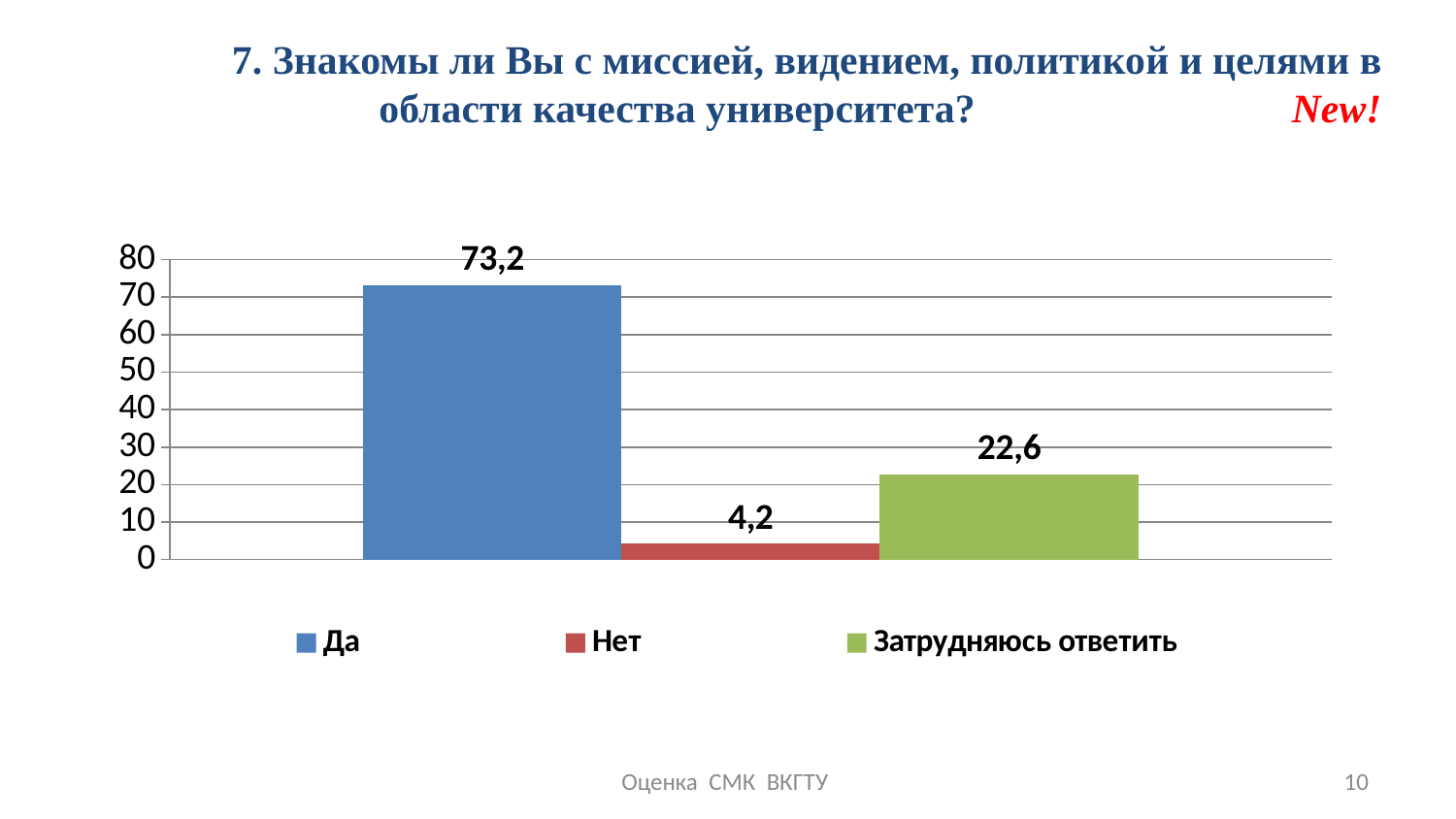
Which category has the lowest value? Нет What is the value for "Нет"? 4,2 What is the value for "Затрудняюсь ответить"? 22,6 What kind of chart is shown on the slide? bar chart How many series does the legend list? 3 Is the value for "Да" greater or less than 70? greater Which category has the highest value? Да What is the difference between the values for "Затрудняюсь ответить" and "Нет"? 18,4 What colour is the bar for "Затрудняюсь ответить"? green What is the difference between the values for "Да" and "Затрудняюсь ответить"? 50,6 What is the value for "Да"? 73,2 Which is larger, the value for "Нет" or the value for "Затрудняюсь ответить"? Затрудняюсь ответить